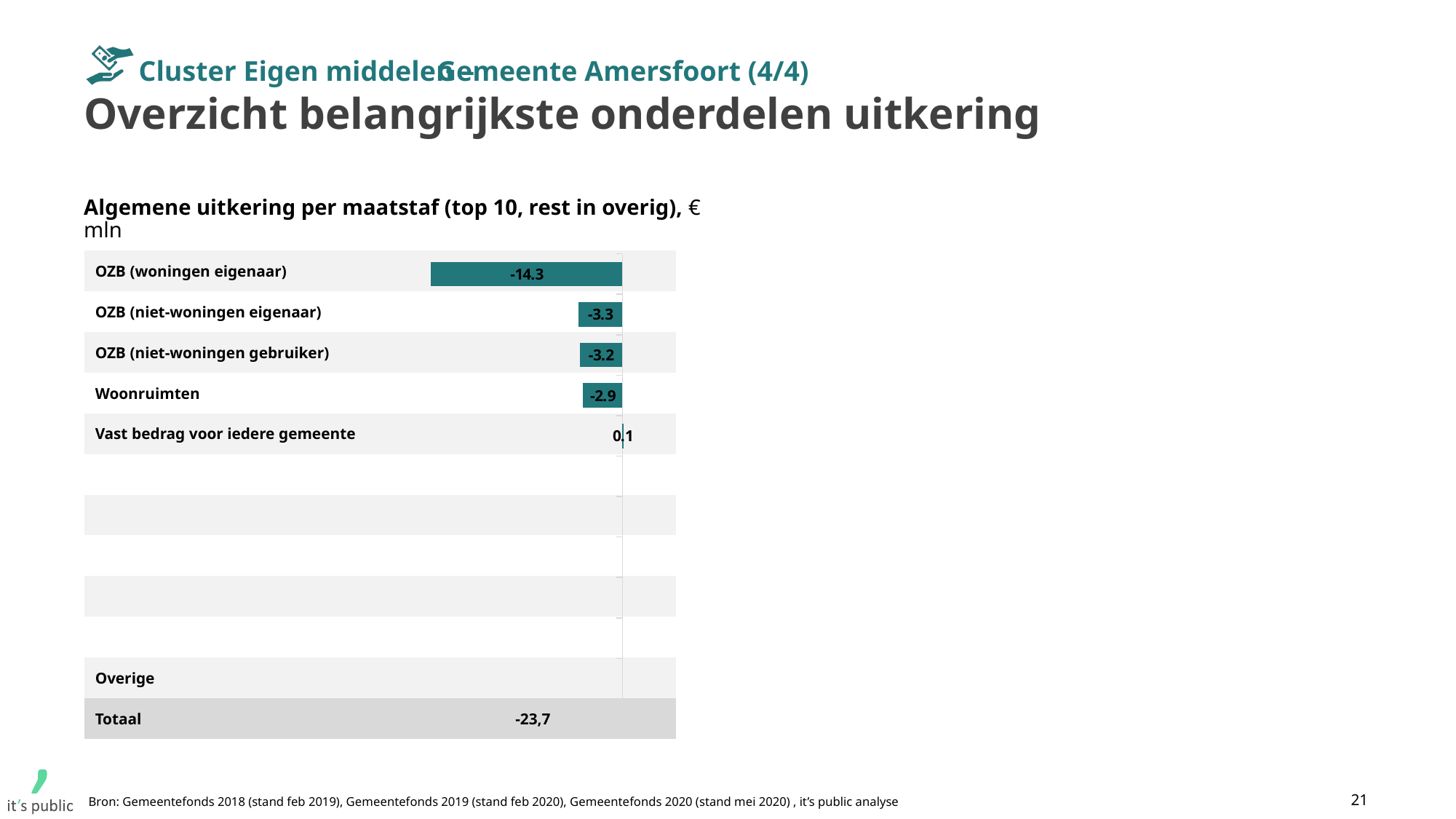
What is the difference between the values for OZB (niet-woningen eigenaar) and OZB (niet-woningen gebruiker)? 0.1 What kind of chart is shown on the slide? Bar chart In what unit are the chart values expressed, according to the chart title? € mln What is the value for OZB (woningen eigenaar)? -14.3 What is the difference between the values for OZB (woningen eigenaar) and Woonruimten? 11.4 Which is larger, the value for OZB (woningen eigenaar) or the value for Woonruimten? Woonruimten Which category has the highest value? Vast bedrag voor iedere gemeente What is the value for Vast bedrag voor iedere gemeente? 0.1 What is the value for Woonruimten? -2.9 Which category has the lowest (most negative) value? OZB (woningen eigenaar) What is the value shown for Totaal? -23,7 How many categories have a negative value printed on the chart? 4